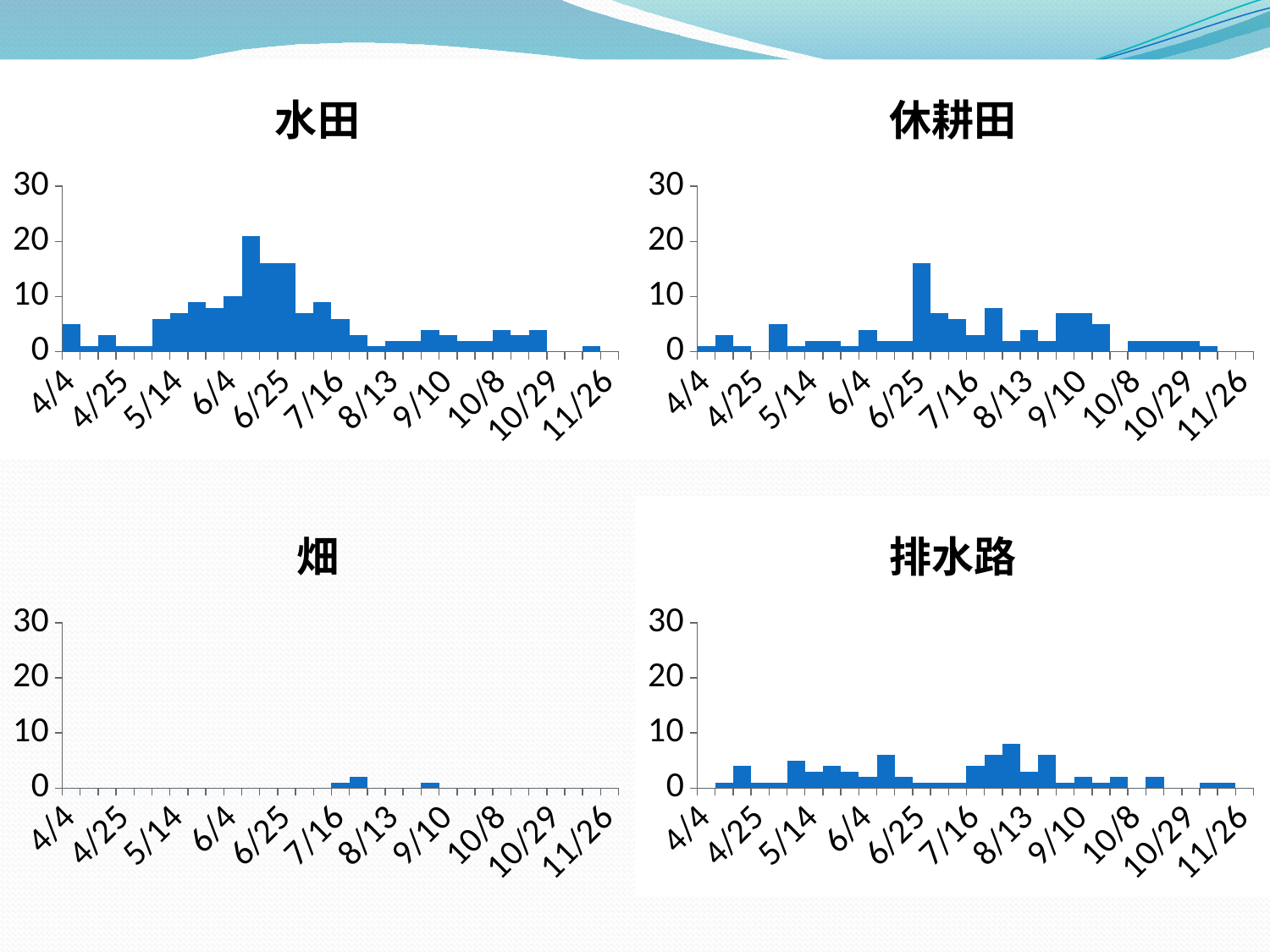
What is the title of the chart in the bottom-right of the slide? 排水路 In the 休耕田 chart, is the highest bar greater or less than 20? less What is the maximum value shown on the vertical axis of the 畑 chart? 30 In the 水田 chart, is the highest bar greater or less than 10? greater In the 水田 chart, is the bar at 6/25 higher or lower than the bar at 4/4? higher Which of the four charts has the tallest bar? 水田 Which of the four charts has the lowest bars overall? 畑 How many charts are shown on the slide? 4 In the 排水路 chart, is the highest bar greater or less than 10? less What kind of chart is the 水田 chart? bar chart